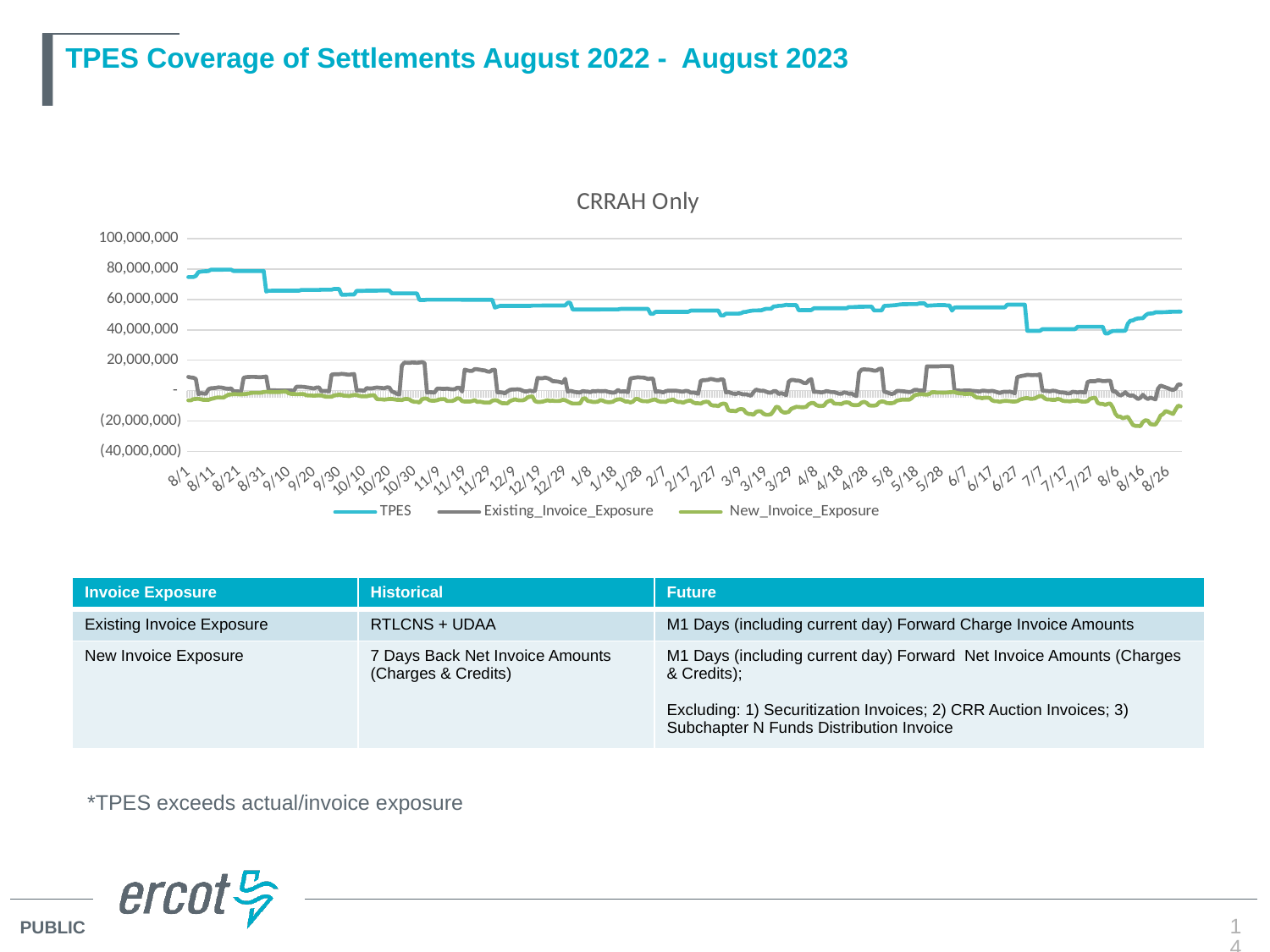
What kind of chart is shown on the slide? Line chart Is the New_Invoice_Exposure value at 8/16 greater or less than 0? less Which series has the highest values across the whole period? TPES Is the TPES value at 8/1 greater or less than 60,000,000? greater How many series does the chart legend list? 3 Which series is plotted in green? New_Invoice_Exposure Which is larger at 8/26, TPES or New_Invoice_Exposure? TPES Is the TPES value at 7/17 greater or less than 60,000,000? less Which series has the lowest value at the end of the period (8/26)? New_Invoice_Exposure Does the TPES line generally rise or fall from 8/1 to 8/26? Fall What is the title of the chart? CRRAH Only